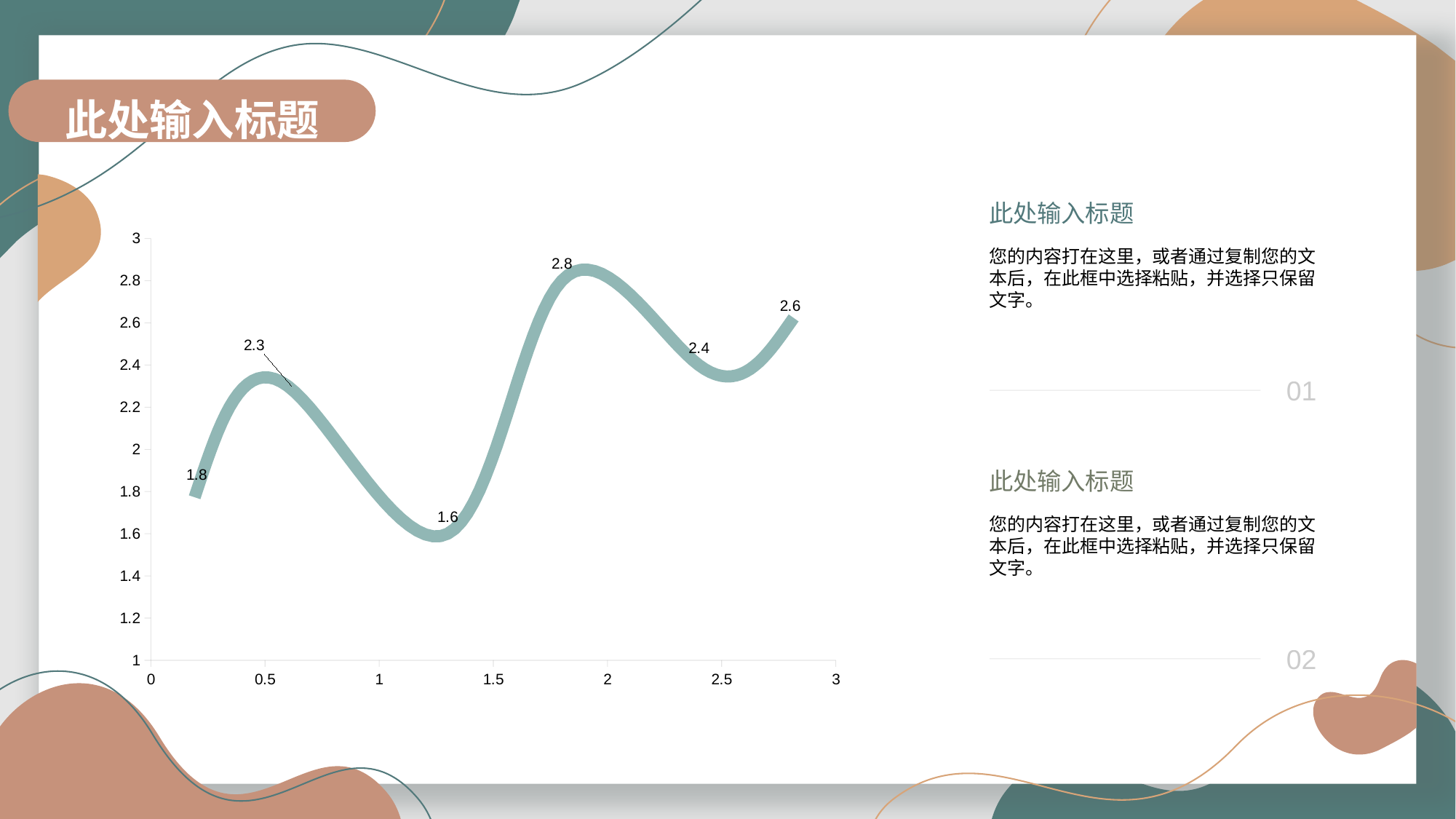
What is the value of the last (rightmost) labelled point on the line? 2.6 What is the highest labelled value on the line? 2.8 What is the difference between the highest labelled value (2.8) and the lowest labelled value (1.6)? 1.2 What is the difference between the second labelled point (2.3) and the first labelled point (1.8)? 0.5 How many labelled data points does the line have? 6 Which is larger: the second labelled point (2.3) or the fifth labelled point (2.4)? 2.4 What kind of chart is shown on the slide? line chart Does the line rise or fall between the third labelled point (1.6) and the fourth labelled point (2.8)? rise What is the minimum value shown on the vertical axis? 1 What is the value of the first (leftmost) labelled point on the line? 1.8 What is the maximum value shown on the vertical axis? 3 What is the lowest labelled value on the line? 1.6